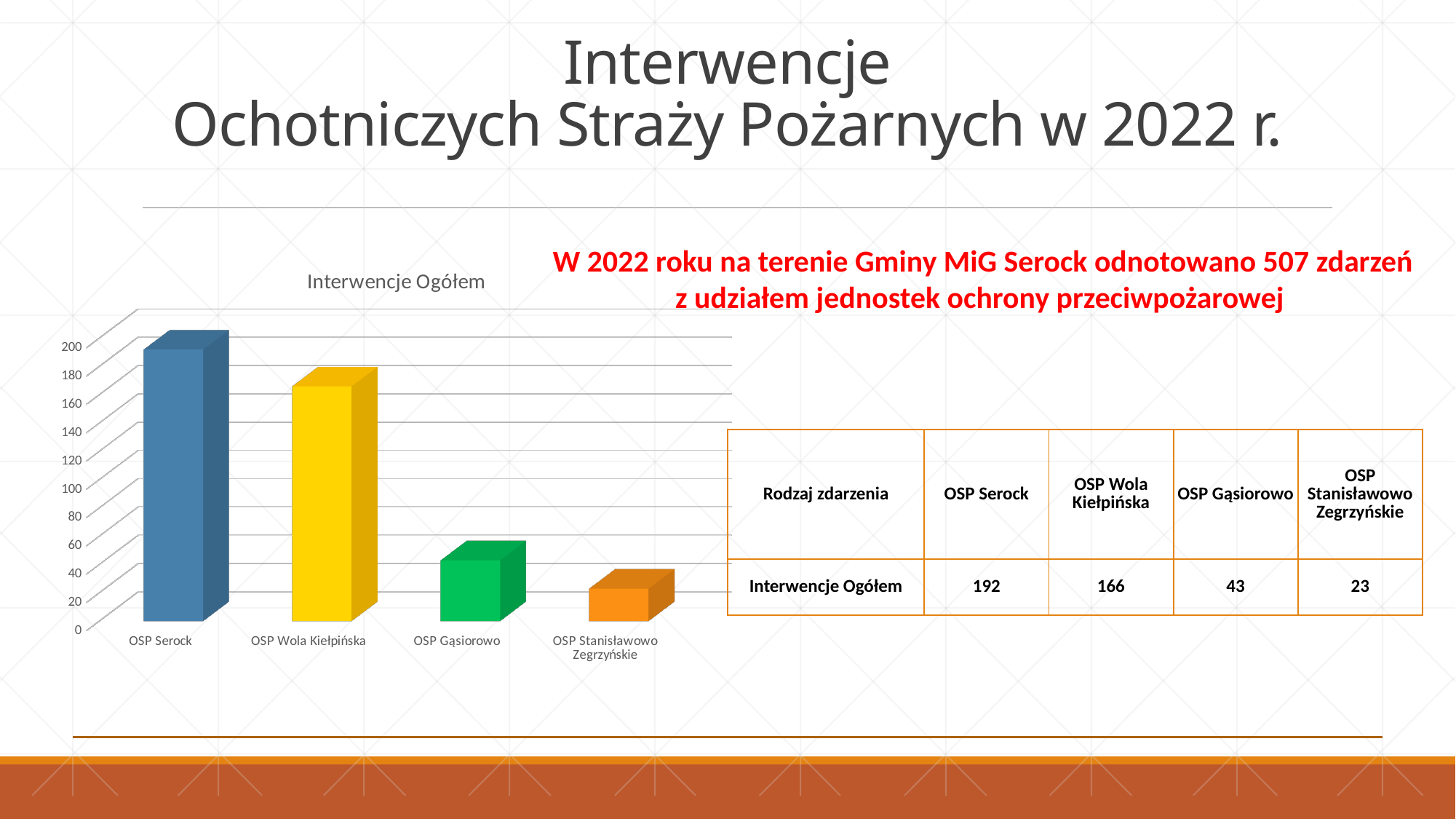
How many categories are shown in the chart? 4 Do the values rise or fall from left to right along the x axis? fall What is the value for OSP Serock? 192 What is the value for OSP Stanisławowo Zegrzyńskie? 23 Which category has the lowest value in the chart? OSP Stanisławowo Zegrzyńskie What is the difference between the values for OSP Serock and OSP Wola Kiełpińska? 26 What is the value for OSP Wola Kiełpińska? 166 What is the title of the chart? Interwencje Ogółem Which category has the highest value in the chart? OSP Serock What type of chart is shown on the slide? bar chart Which is larger, the value for OSP Gąsiorowo or OSP Stanisławowo Zegrzyńskie? OSP Gąsiorowo What is the value for OSP Gąsiorowo? 43